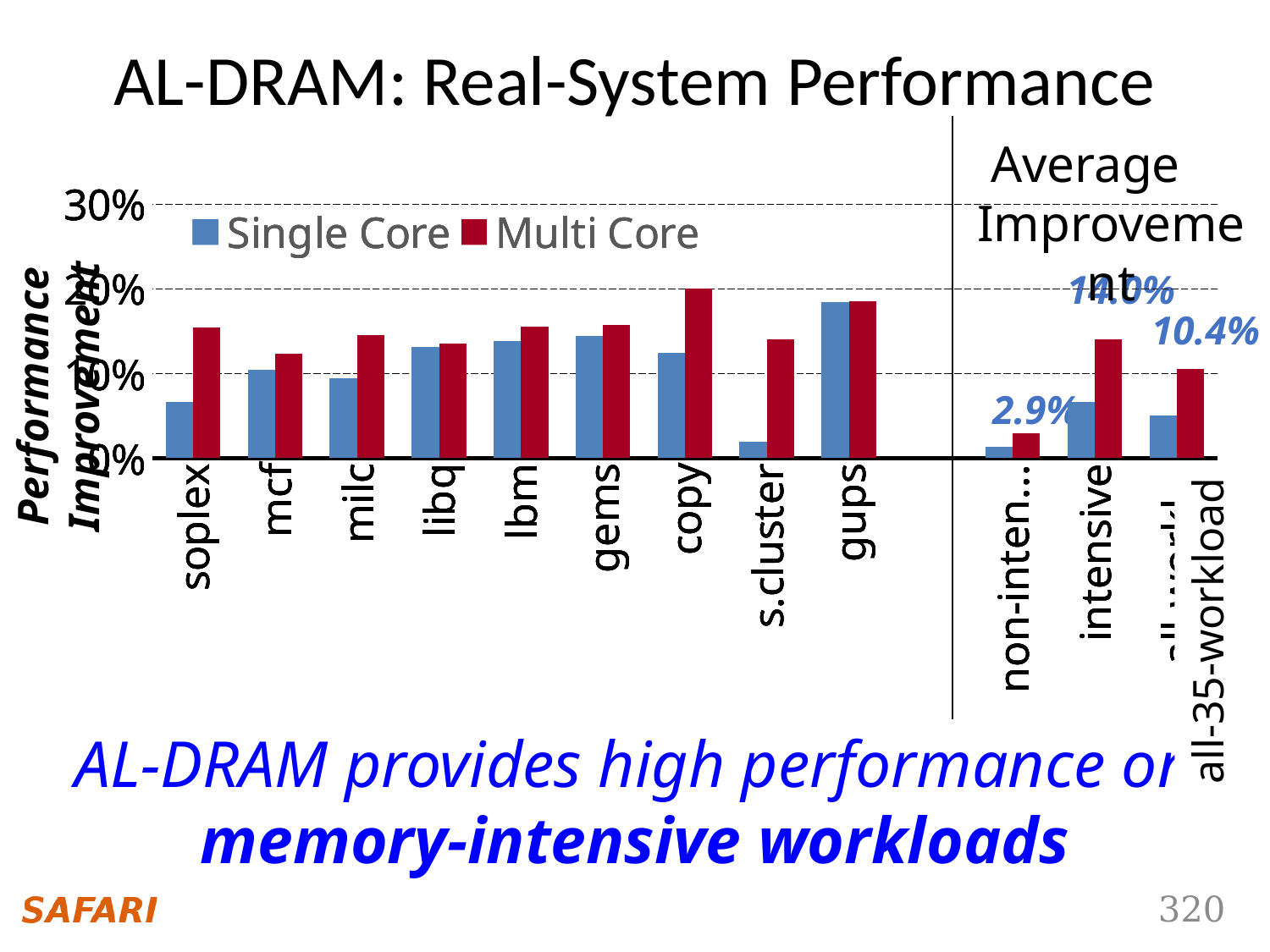
Is the Multi Core value for copy greater or less than 10%? greater Which workload has the highest Multi Core performance improvement? copy How many series does the chart's legend list? 2 Among the nine individual workloads to the left of the divider, which has the lowest Single Core performance improvement? s.cluster Is the Multi Core value for soplex greater or less than 10%? greater How many individual workloads are plotted to the left of the vertical divider line? 9 For s.cluster, which is larger: the Single Core or the Multi Core performance improvement? Multi Core What kind of chart is shown on the slide? bar chart Is the Single Core value for s.cluster greater or less than 10%? less What are the two series named in the chart's legend? Single Core and Multi Core Which workload has the highest Single Core performance improvement? gups For soplex, which is larger: the Single Core or the Multi Core performance improvement? Multi Core